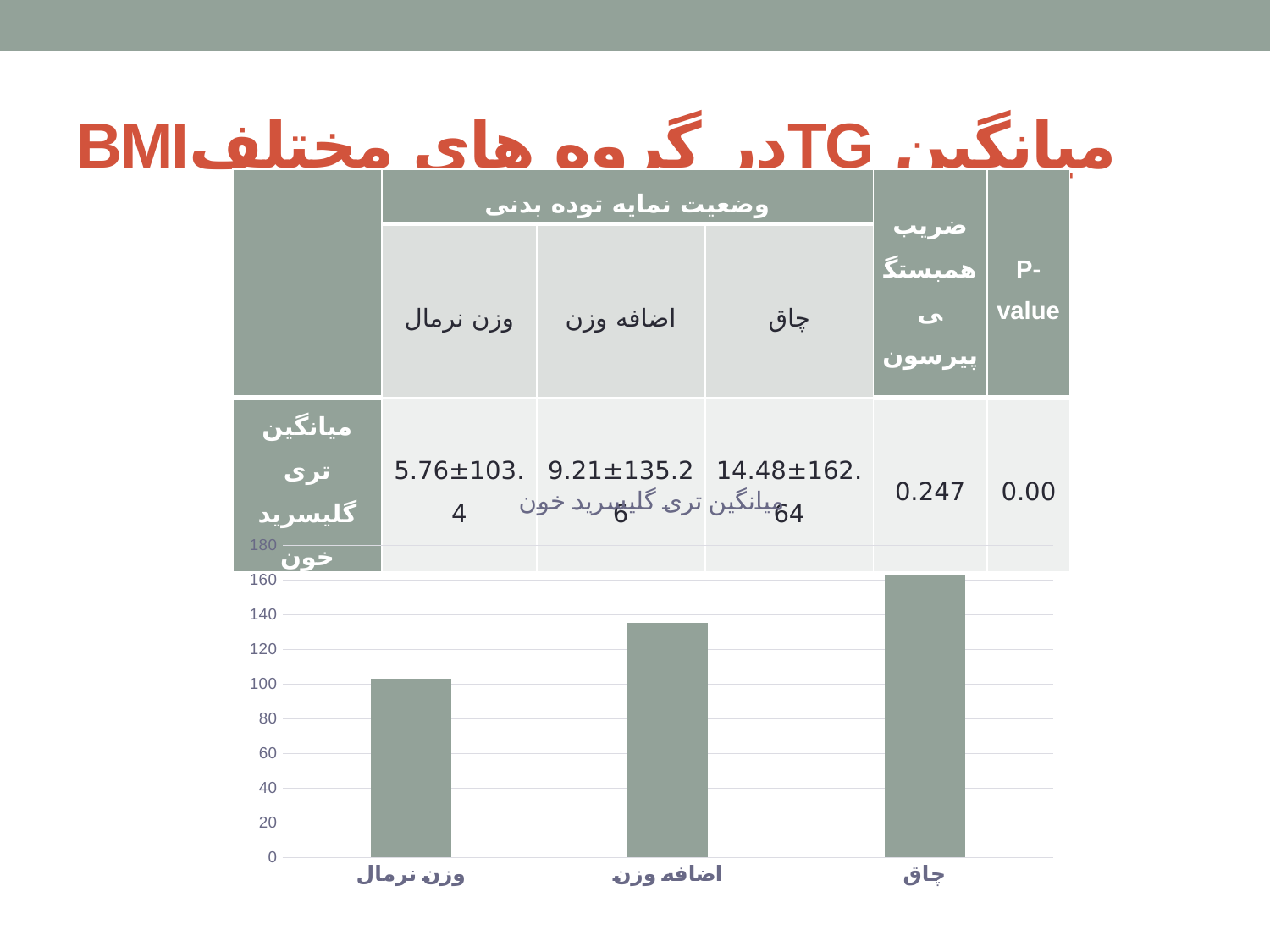
What is the highest tick value shown on the vertical axis of the chart? 180 Is the value for وزن نرمال greater or less than 100? greater Is the value for اضافه وزن greater or less than 140? less Do the bar values rise or fall from left to right across the categories? rise Which category has the lowest bar in the chart? وزن نرمال Is the value for وزن نرمال greater or less than 120? less Which category has the highest bar in the chart? چاق How many categories are plotted in the bar chart? 3 What kind of chart is shown on the slide? bar chart Which is larger, the value for اضافه وزن or the value for وزن نرمال? اضافه وزن